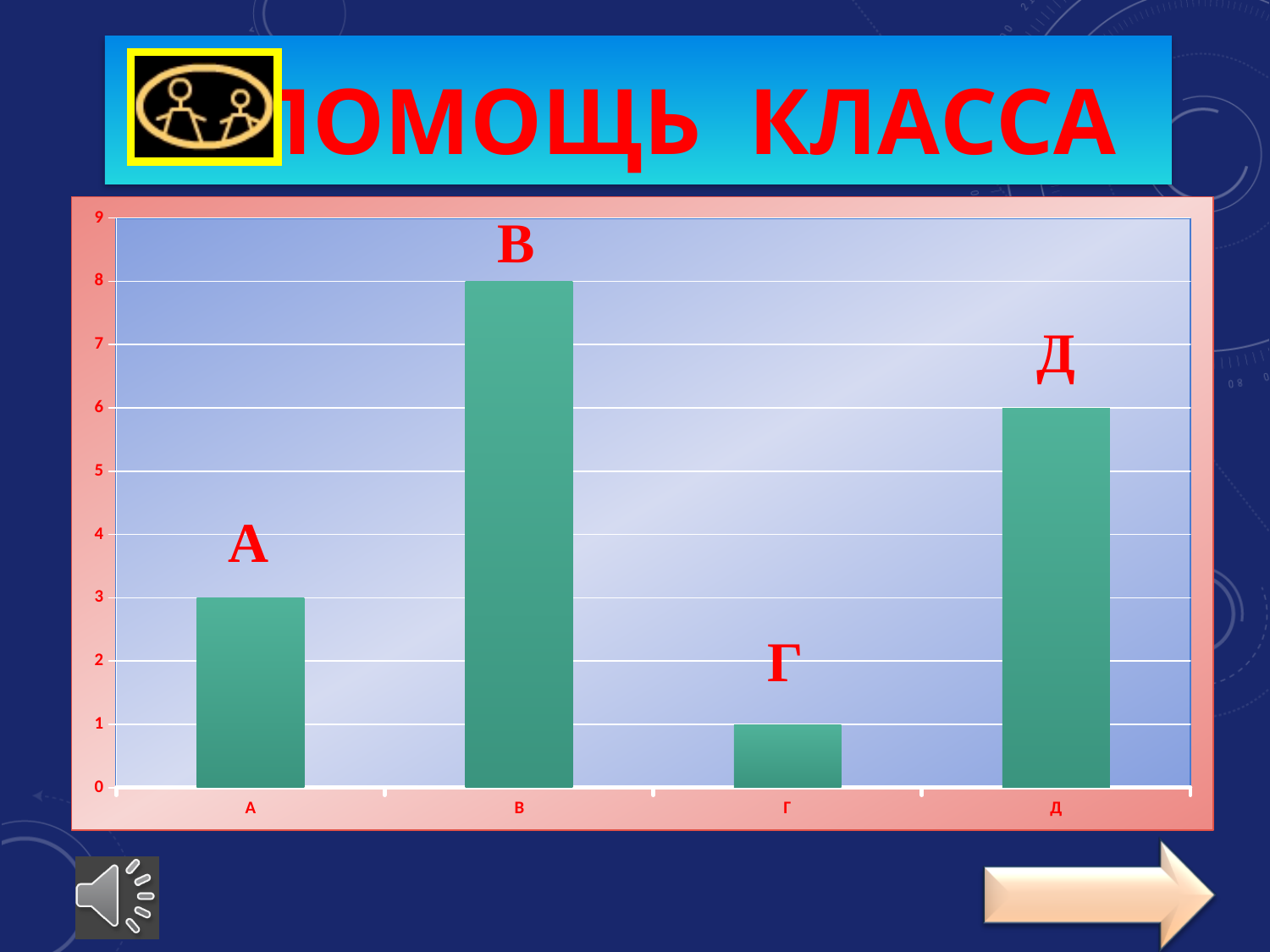
What is the difference between the values for В and Д? 2 What is the highest value shown on the vertical axis? 9 What is the value of the bar for category Г? 1 What kind of chart is shown on the slide? bar chart How many categories are shown on the x axis? 4 Which category has the lowest bar? Г Which category has the highest bar? В What is the value of the bar for category А? 3 Which is larger, the value for А or the value for Д? Д Is the value for В greater or less than 7? greater What is the value of the bar for category Д? 6 What is the value of the bar for category В? 8